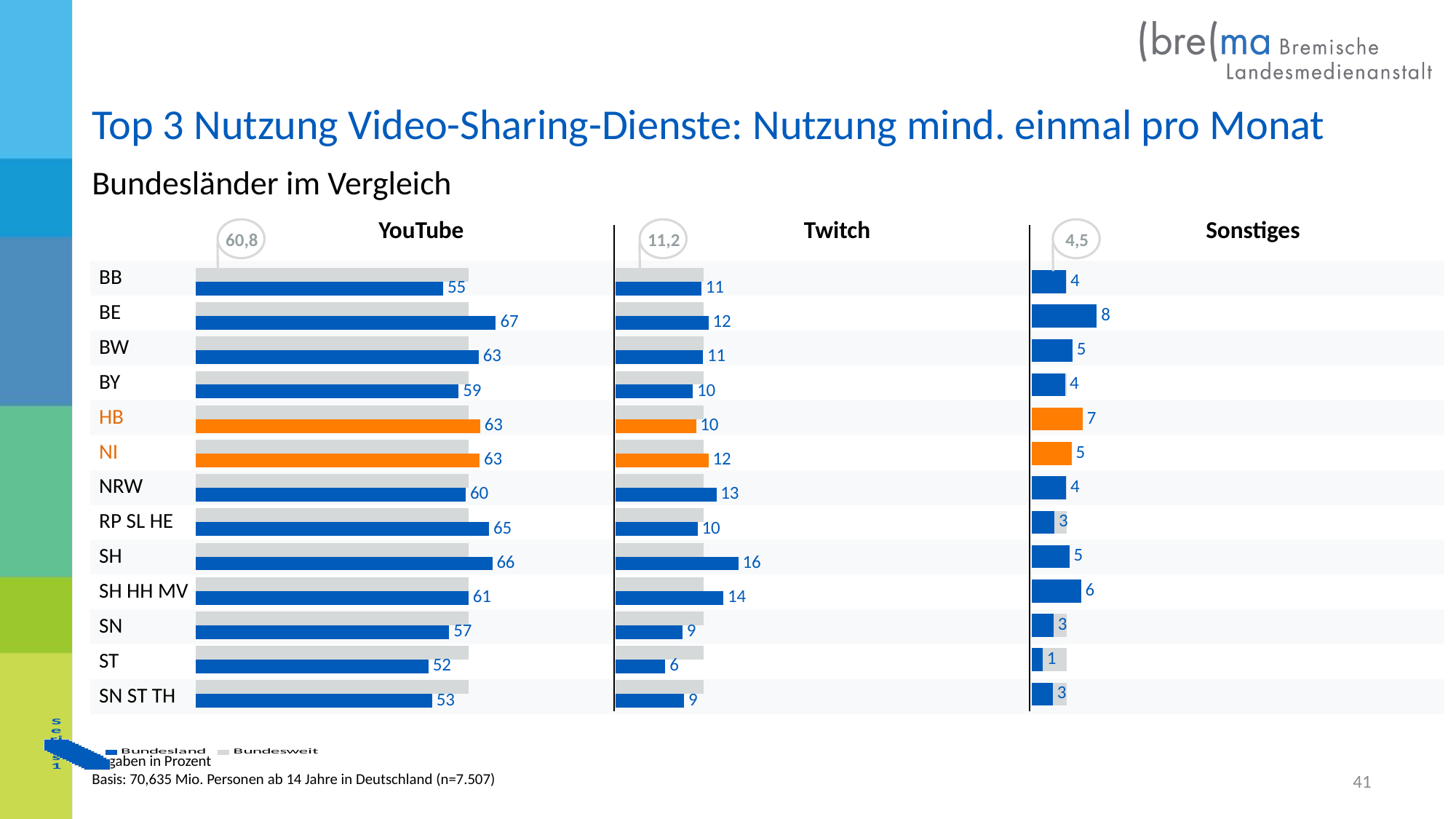
In the Twitch chart, which Bundesland has the lowest value? ST In the Sonstiges chart, what is the value for HB? 7 In the YouTube chart, which Bundesland has the highest value? BE Which two Bundesländer are highlighted in orange in the charts? HB and NI In the Sonstiges chart, which Bundesland has the highest value? BE In the Twitch chart, what is the value for SH HH MV? 14 In the YouTube chart, what is the value for BE? 67 In the Twitch chart, which is larger, the value for SH or the value for NRW? SH In the YouTube chart, what is the difference between the values for BE and ST? 15 What is the Bundesweit (nationwide) value shown for Twitch? 11,2 How many Bundesländer (categories) are shown in the YouTube chart? 13 What type of chart is used for the YouTube data? Bar chart